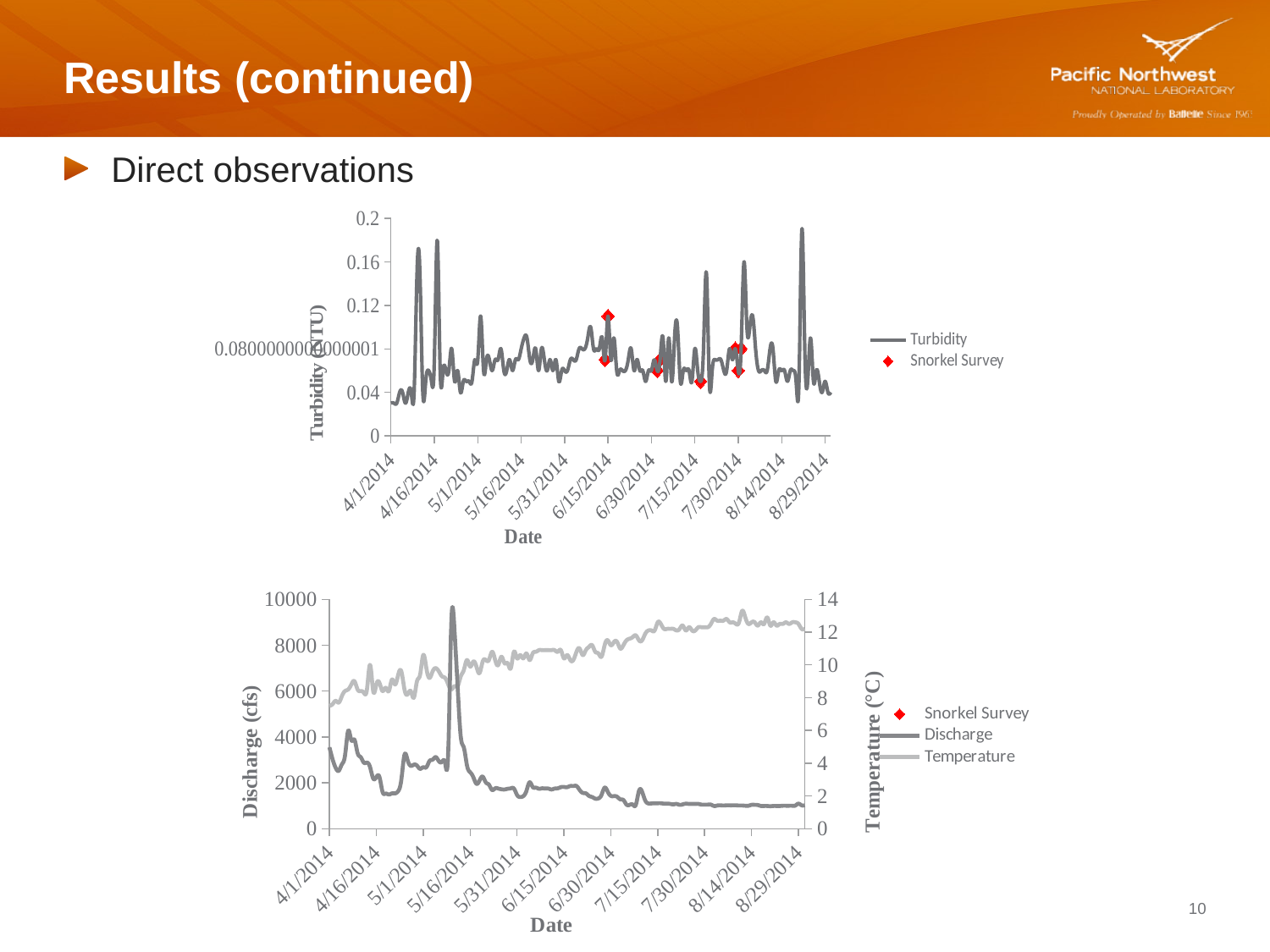
What kind of chart is the top chart (Turbidity vs Date)? line chart On the top chart, is the highest turbidity peak greater or less than 0.16? greater On the top chart, what is the maximum value shown on the turbidity axis? 0.2 How many series does the legend of the bottom chart (Discharge and Temperature) list? 3 On the bottom chart, is the peak discharge value greater or less than 8000? greater What is the label of the y axis on the top chart? Turbidity (NTU) On the bottom chart, is the discharge value at 8/29/2014 greater or less than 2000? less How many series does the legend of the top chart list? 2 On the bottom chart, does the temperature generally rise or fall from 4/1/2014 to 8/29/2014? rise On the bottom chart, does the discharge generally rise or fall from 5/16/2014 to 8/29/2014? fall